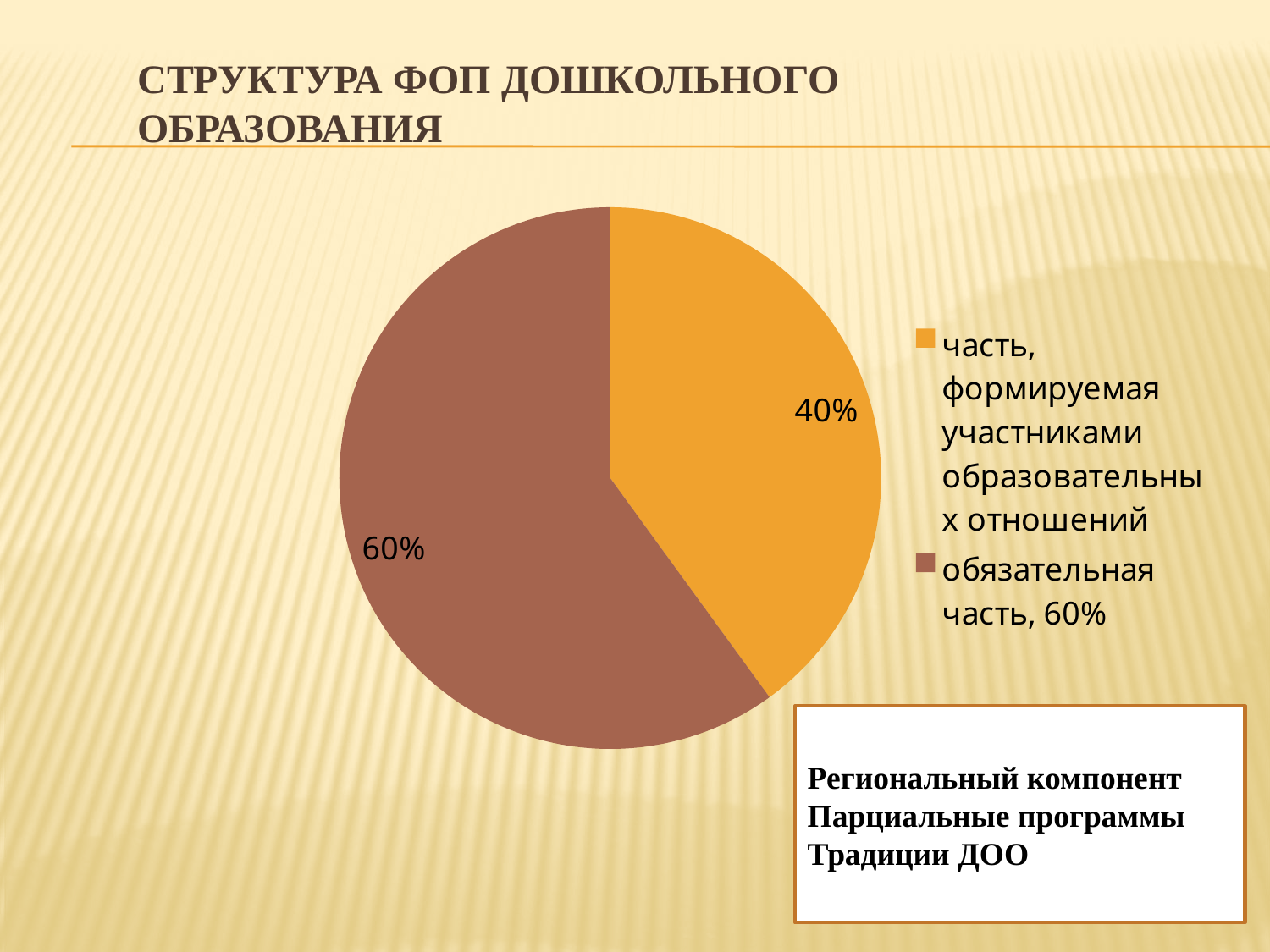
What kind of chart is shown on the slide? pie chart What share of the pie does the slice 'обязательная часть' take? 60% Which is larger: the 'обязательная часть' slice or the 'часть, формируемая участниками образовательных отношений' slice? обязательная часть How many slices does the pie chart have? 2 What colour is the 'часть, формируемая участниками образовательных отношений' slice? orange What share of the pie does the slice 'часть, формируемая участниками образовательных отношений' take? 40% What colour is the 'обязательная часть' slice? brown Is the value for 'обязательная часть' greater or less than 50%? greater Which slice is the smallest in the pie chart? часть, формируемая участниками образовательных отношений What is the difference in percentage points between the 'обязательная часть' slice and the 'часть, формируемая участниками образовательных отношений' slice? 20% How many entries does the legend list? 2 Which slice is the largest in the pie chart? обязательная часть